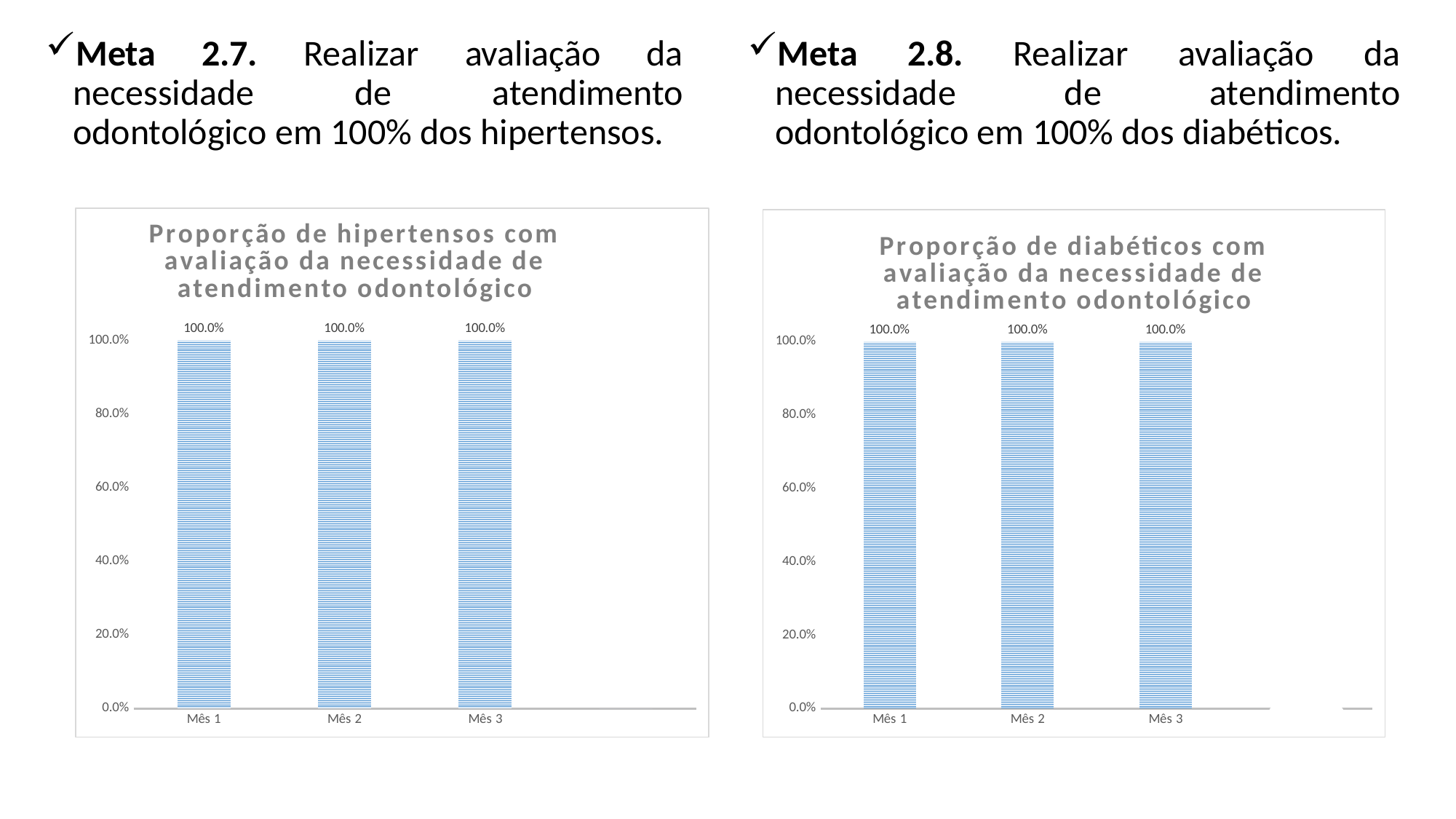
In the right chart (Proporção de diabéticos com avaliação da necessidade de atendimento odontológico), how many bars are plotted? 3 In the left chart (Proporção de hipertensos com avaliação da necessidade de atendimento odontológico), what is the difference between the values for Mês 1 and Mês 2? 0.0% What kind of chart is the right chart (Proporção de diabéticos com avaliação da necessidade de atendimento odontológico)? Bar chart What kind of chart is the left chart (Proporção de hipertensos com avaliação da necessidade de atendimento odontológico)? Bar chart In the left chart (Proporção de hipertensos com avaliação da necessidade de atendimento odontológico), what is the value for Mês 3? 100.0% In the right chart (Proporção de diabéticos com avaliação da necessidade de atendimento odontológico), do the values rise, fall or stay the same from Mês 1 to Mês 3? Stay the same In the right chart (Proporção de diabéticos com avaliação da necessidade de atendimento odontológico), what is the value for Mês 2? 100.0% In the right chart (Proporção de diabéticos com avaliação da necessidade de atendimento odontológico), what is the value for Mês 3? 100.0% In the left chart (Proporção de hipertensos com avaliação da necessidade de atendimento odontológico), how many categories are shown on the x axis? 3 In the left chart (Proporção de hipertensos com avaliação da necessidade de atendimento odontológico), is the value for Mês 2 greater or less than 80.0%? greater What is the title of the right chart? Proporção de diabéticos com avaliação da necessidade de atendimento odontológico In the left chart (Proporção de hipertensos com avaliação da necessidade de atendimento odontológico), what is the value for Mês 1? 100.0%